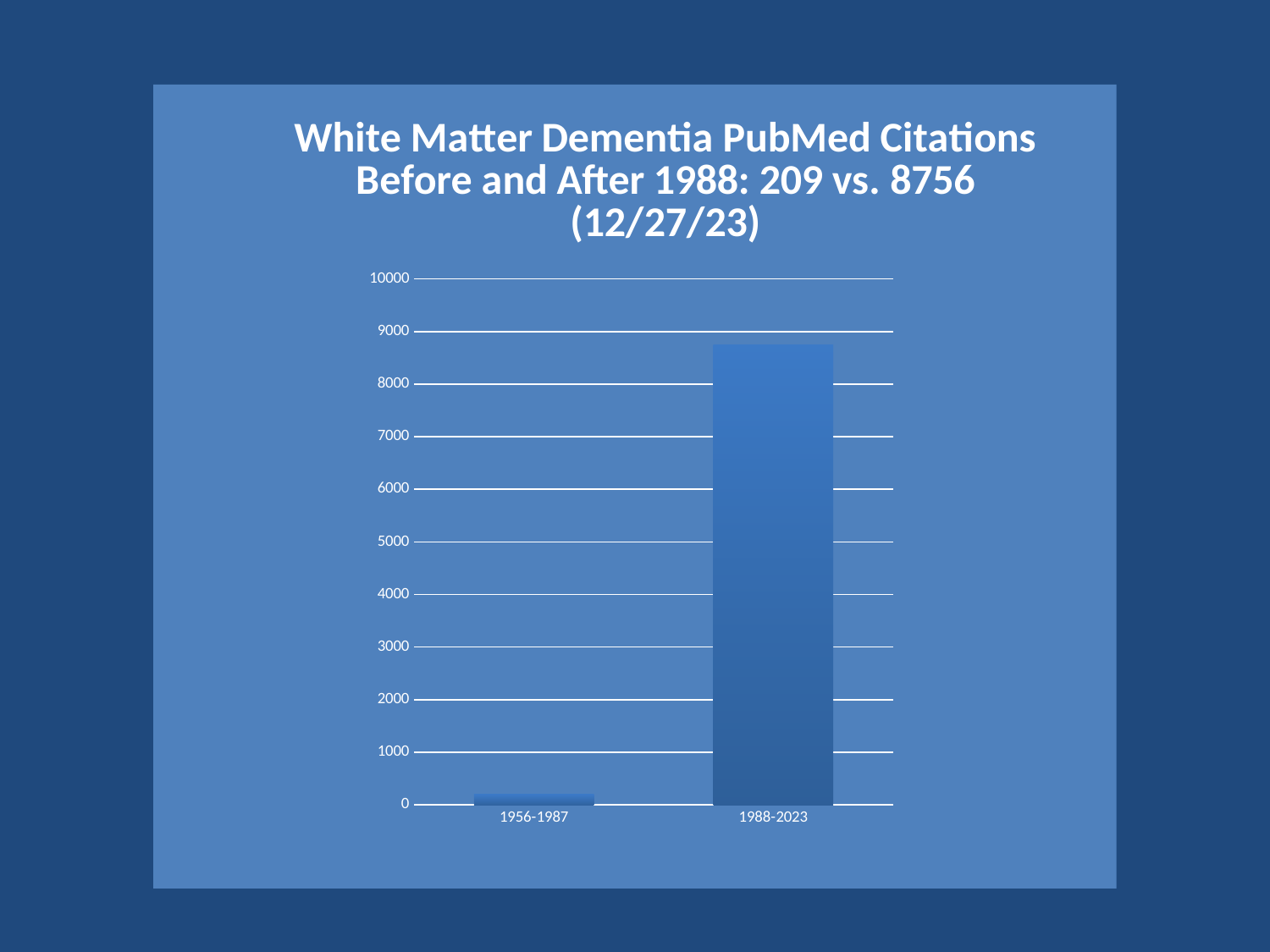
Which is larger, the value for 1956-1987 or the value for 1988-2023? 1988-2023 What type of chart is shown on the slide? bar chart What is the highest value shown on the y axis of the chart? 10000 According to the slide, how many PubMed citations were there for 1988-2023? 8756 What is the difference between the citation counts for 1988-2023 and 1956-1987 as stated on the slide? 8547 Which category has the lowest value in the chart? 1956-1987 Is the value for 1988-2023 greater or less than 8000? greater Is the value for 1956-1987 greater or less than 1000? less Is the value for 1988-2023 greater or less than 9000? less According to the slide, how many PubMed citations were there for 1956-1987? 209 Which category has the highest value in the chart? 1988-2023 How many categories are shown on the x axis of the chart? 2